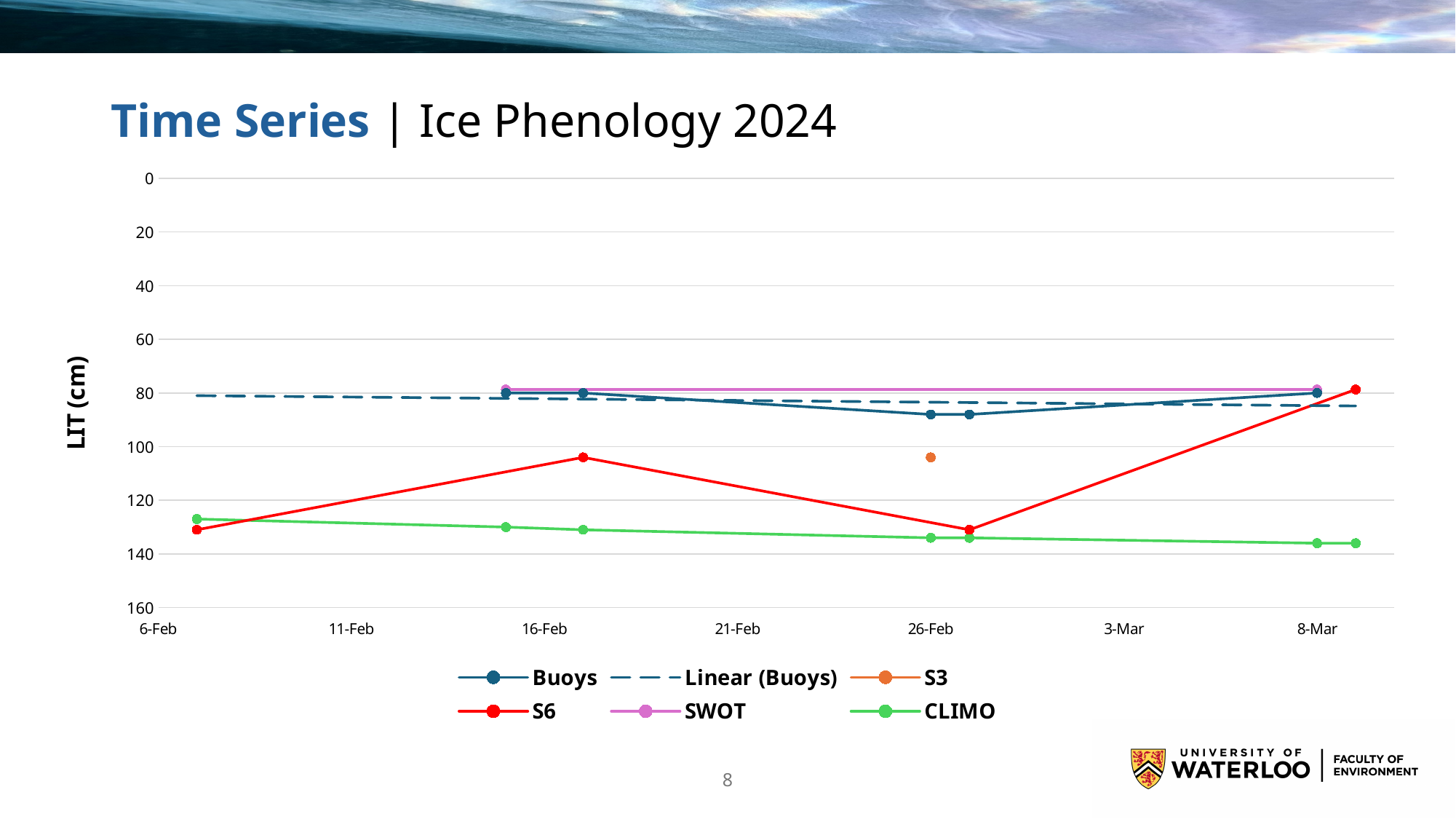
Is the CLIMO value on 8-Mar greater or less than 120? greater What kind of chart is shown on the slide? line chart Do the CLIMO values increase or decrease from 6-Feb to 8-Mar? increase On 26-Feb, which has the larger LIT value, S3 or Buoys? S3 How many data points are plotted for the S3 series? 1 Is the Buoys value on 26-Feb greater or less than 100? less Is the S6 value near 16-Feb greater or less than 100? greater Which series is drawn as a dashed line? Linear (Buoys) What is the label of the y axis? LIT (cm) How many data points are plotted for the S6 series? 4 How many series does the legend list? 6